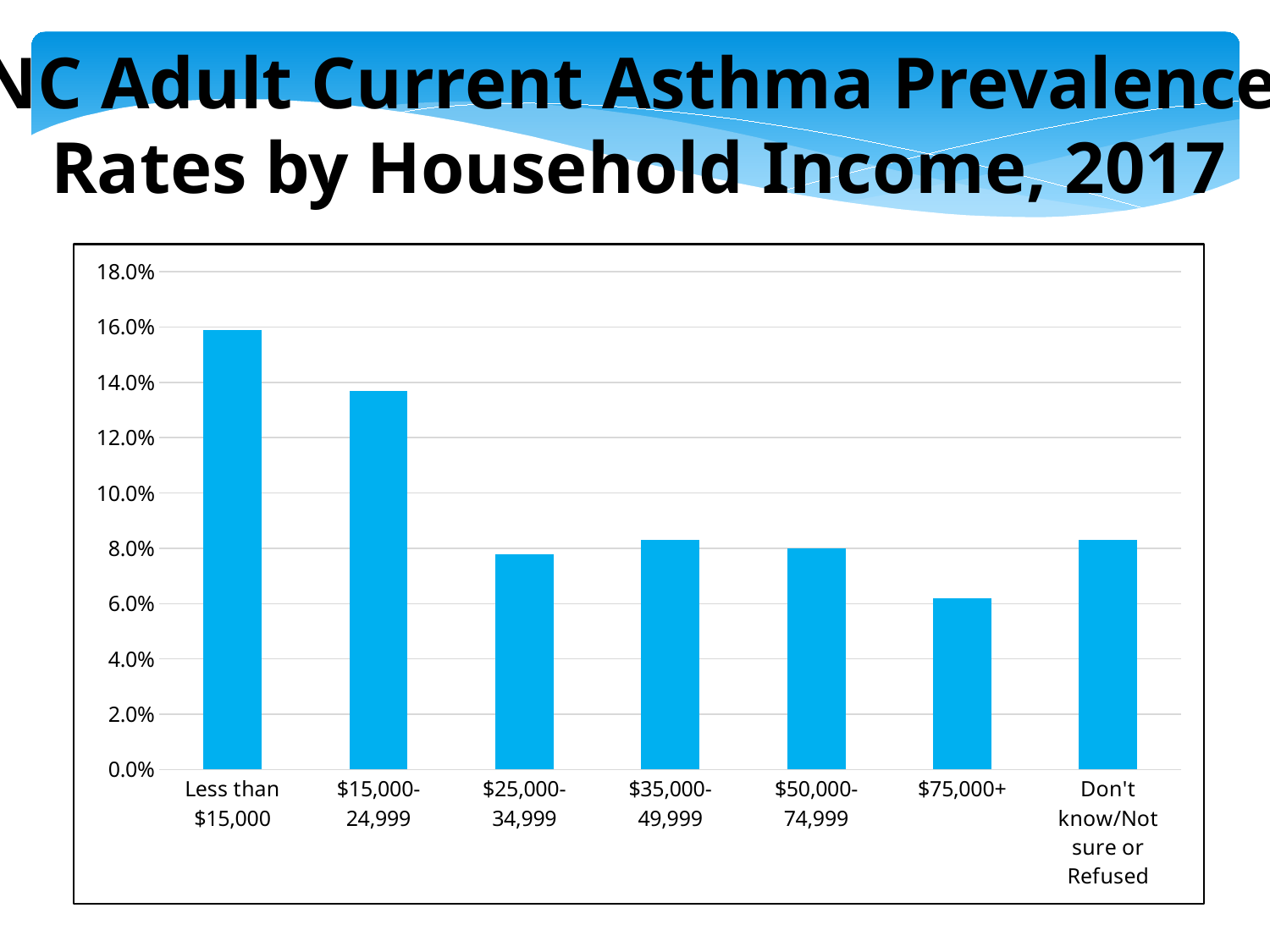
Which has a higher asthma prevalence rate: Less than $15,000 or $15,000-24,999? Less than $15,000 How many household income categories are shown on the x axis? 7 Which household income category has the lowest asthma prevalence rate? $75,000+ Is the value for Less than $15,000 greater or less than 14.0%? greater Is the value for Don't know/Not sure or Refused greater or less than 6.0%? greater Which household income category has the highest asthma prevalence rate? Less than $15,000 Is the value for $15,000-24,999 greater or less than 12.0%? greater Which has a higher asthma prevalence rate: $50,000-74,999 or $75,000+? $50,000-74,999 What kind of chart is shown on the slide? bar chart What is the highest value shown on the y axis? 18.0%